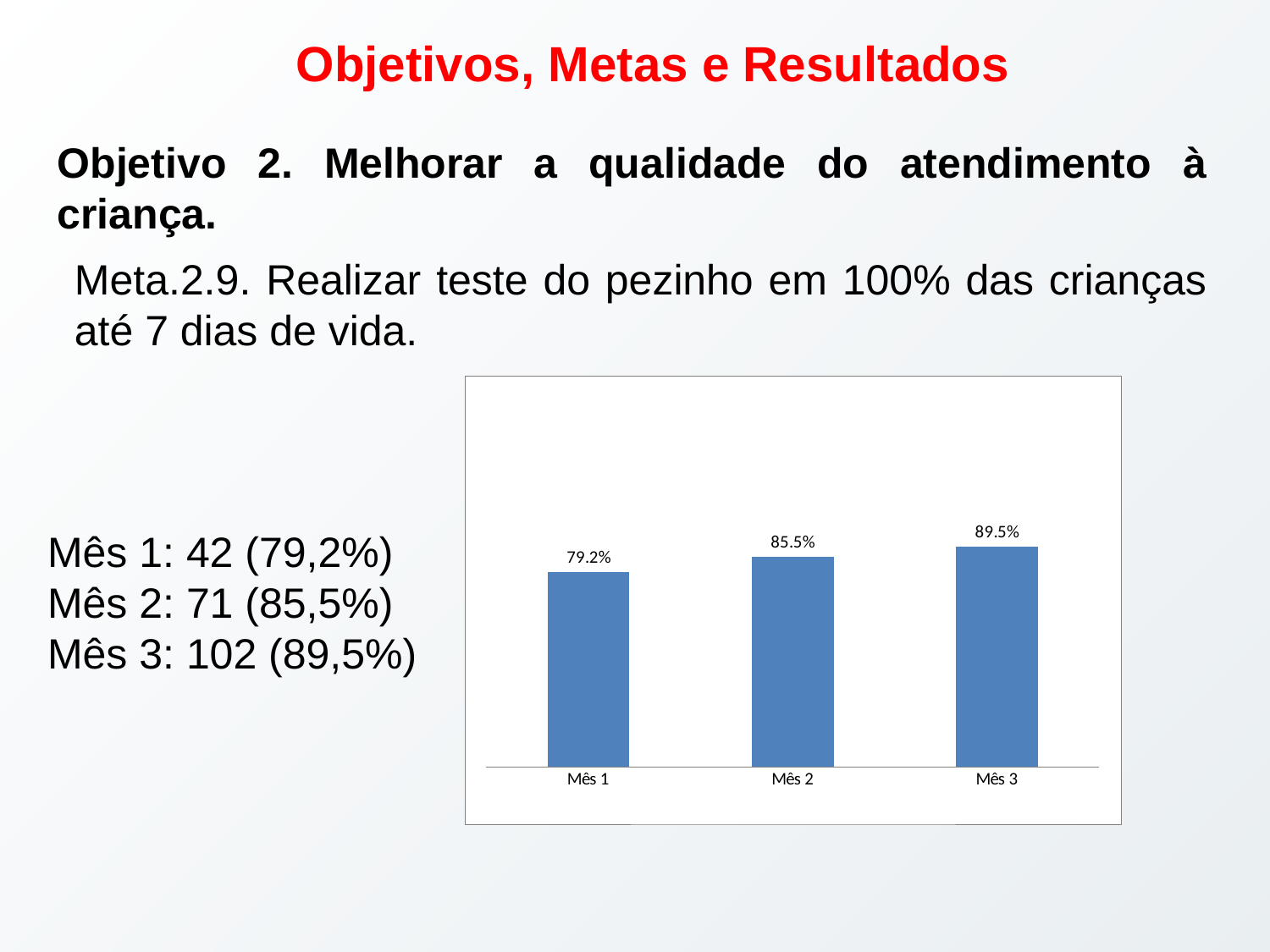
What colour are the bars in the chart? Blue Which is larger, the value for Mês 2 or the value for Mês 3? Mês 3 What is the difference between the values for Mês 2 and Mês 1? 6.3% Which category has the highest value? Mês 3 What is the value for Mês 1? 79.2% What is the value for Mês 2? 85.5% What is the difference between the values for Mês 3 and Mês 1? 10.3% What is the value for Mês 3? 89.5% Do the values rise or fall from Mês 1 to Mês 3? Rise Which category has the lowest value? Mês 1 How many categories are shown on the x axis? 3 What kind of chart is shown on the slide? Bar chart